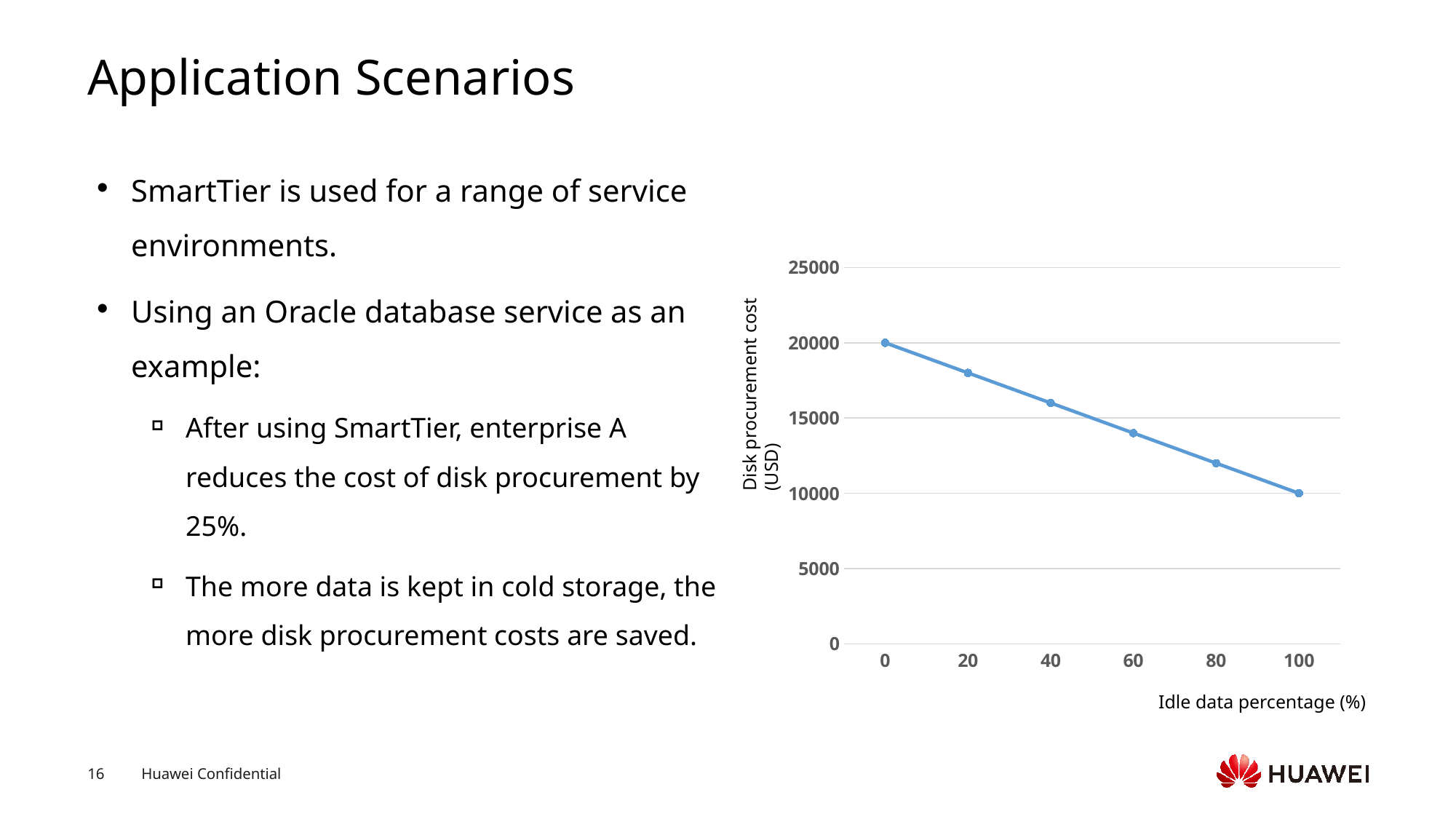
What is the label of the x axis? Idle data percentage (%) How many data points are plotted on the line? 6 What kind of chart is shown on the slide? line chart Is the disk procurement cost at an idle data percentage of 20 greater or less than 15000? greater What is the disk procurement cost when the idle data percentage is 0? 20000 Is the disk procurement cost at an idle data percentage of 80 greater or less than 15000? less At which idle data percentage is the disk procurement cost highest? 0 Which has a larger disk procurement cost: an idle data percentage of 40 or 60? 40 At which idle data percentage is the disk procurement cost lowest? 100 What is the disk procurement cost when the idle data percentage is 100? 10000 What is the difference in disk procurement cost between an idle data percentage of 0 and 100? 10000 Does the disk procurement cost rise or fall as the idle data percentage increases? fall